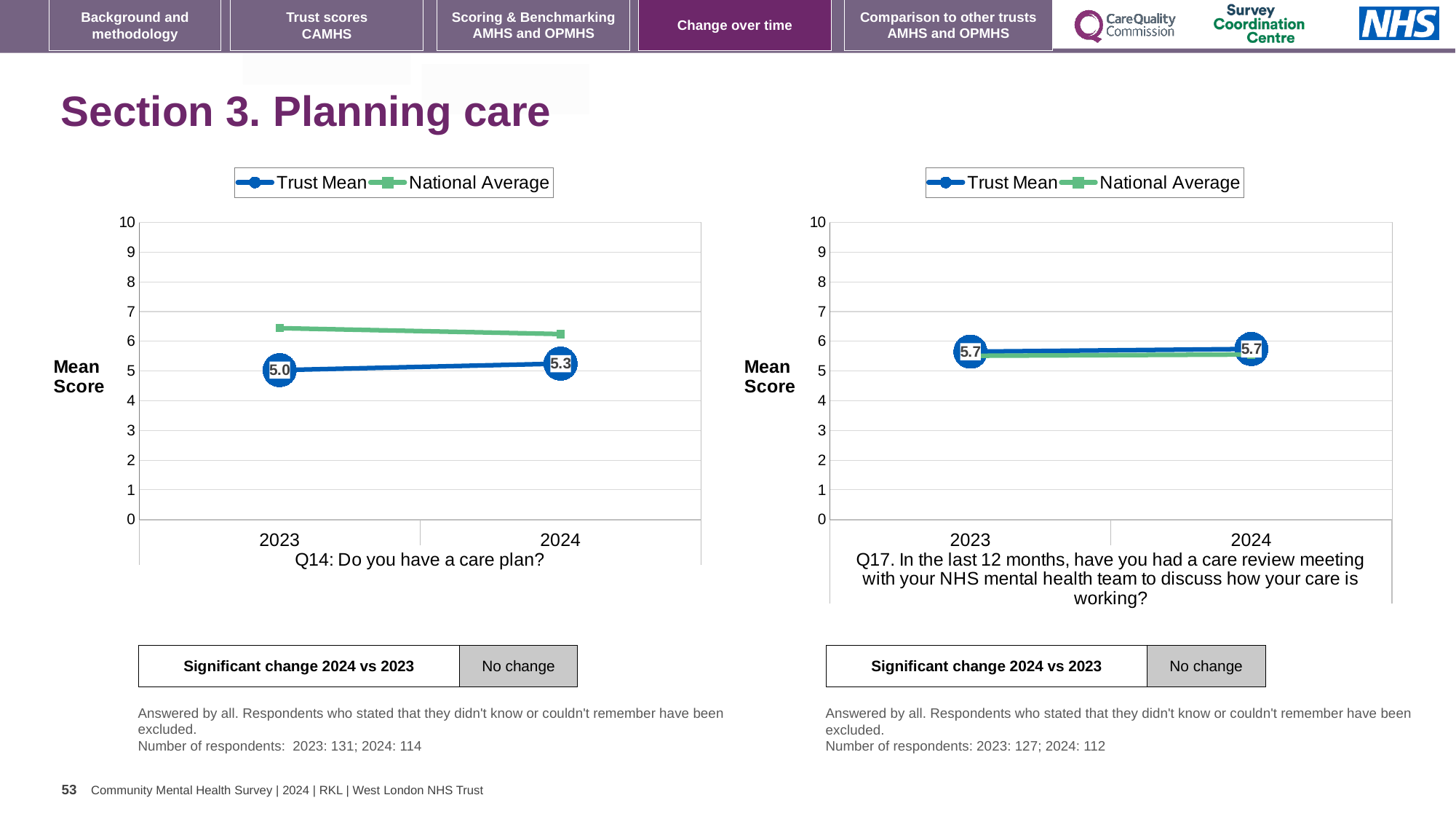
How many series does the legend of the right chart (Q17) list? 2 In the left chart (Q14), which is higher in 2023, the Trust Mean or the National Average? National Average In the right chart (Q17), does the Trust Mean rise, fall or stay the same from 2023 to 2024? stay the same In the left chart (Q14), by how much did the Trust Mean change from 2023 to 2024? 0.3 In the left chart (Q14), does the Trust Mean rise or fall from 2023 to 2024? rise In the left chart (Q14), is the National Average for 2024 greater or less than 6? greater In the left chart (Q14: Do you have a care plan?), what is the Trust Mean for 2023? 5.0 How many years are shown on the x axis of the left chart (Q14)? 2 In the right chart (Q17), is the National Average for 2023 greater or less than 5? greater What kind of chart is the left chart (Q14)? line chart In the left chart (Q14: Do you have a care plan?), what is the Trust Mean for 2024? 5.3 In the right chart (Q17 care review meeting), what is the Trust Mean for 2024? 5.7